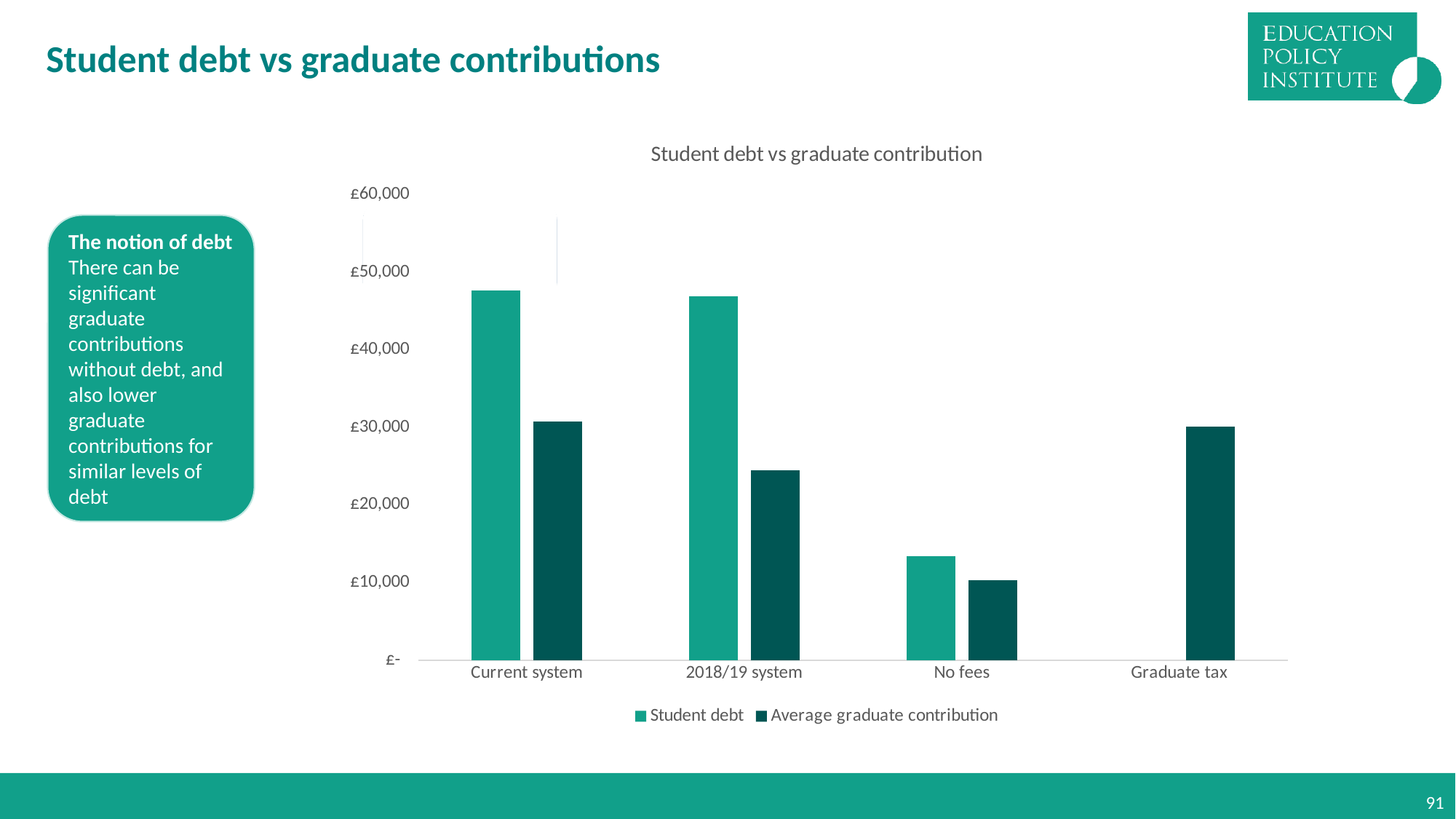
Which has the larger Average graduate contribution: 2018/19 system or No fees? 2018/19 system For Current system, which is larger: Student debt or Average graduate contribution? Student debt Is the Average graduate contribution value for Graduate tax greater or less than £40,000? less How many categories are shown on the x axis of the chart? 4 Is the Student debt value for Current system greater or less than £40,000? greater Which category has the lowest Average graduate contribution? No fees What kind of chart is shown on the slide? Bar chart Which series is shown in the darker green bars? Average graduate contribution How many series does the chart's legend list? 2 What is the title of the chart? Student debt vs graduate contribution Is the Average graduate contribution value for 2018/19 system greater or less than £30,000? less